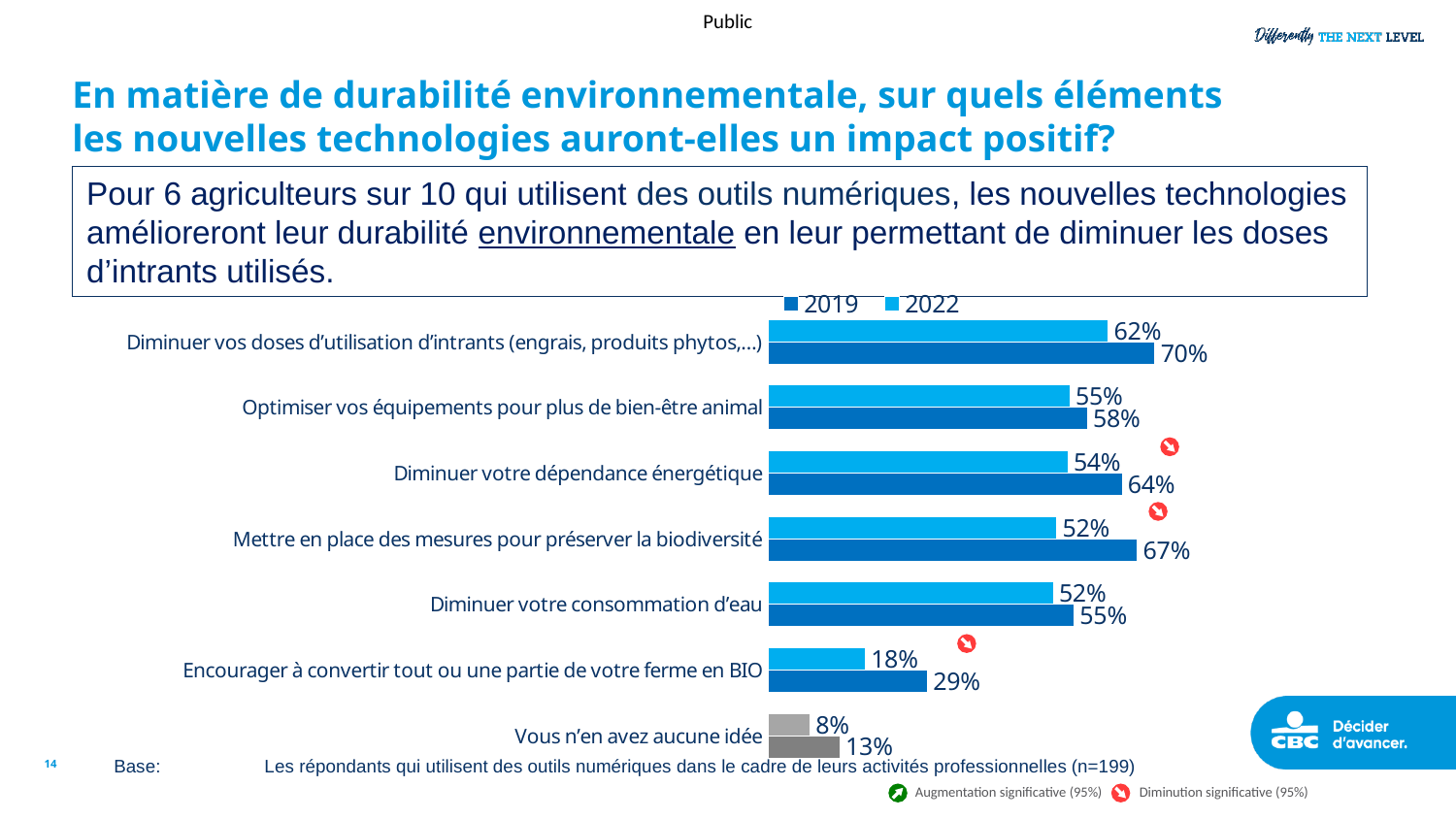
For 'Optimiser vos équipements pour plus de bien-être animal', which year has the larger value, 2019 or 2022? 2019 Which two years are listed in the chart legend? 2019 and 2022 What is the 2022 value for 'Diminuer vos doses d'utilisation d'intrants (engrais, produits phytos,...)'? 62% Which category has the lowest 2019 value? Vous n'en avez aucune idée How many series does the chart legend list? 2 What type of chart is shown on the slide? bar chart What is the 2022 value for 'Encourager à convertir tout ou une partie de votre ferme en BIO'? 18% How many categories are shown in the chart? 7 Which category has the highest 2022 value? Diminuer vos doses d'utilisation d'intrants (engrais, produits phytos,...) What is the difference between the 2019 and 2022 values for 'Vous n'en avez aucune idée'? 5% What is the difference between the 2019 and 2022 values for 'Diminuer votre dépendance énergétique'? 10% What is the 2019 value for 'Mettre en place des mesures pour préserver la biodiversité'? 67%